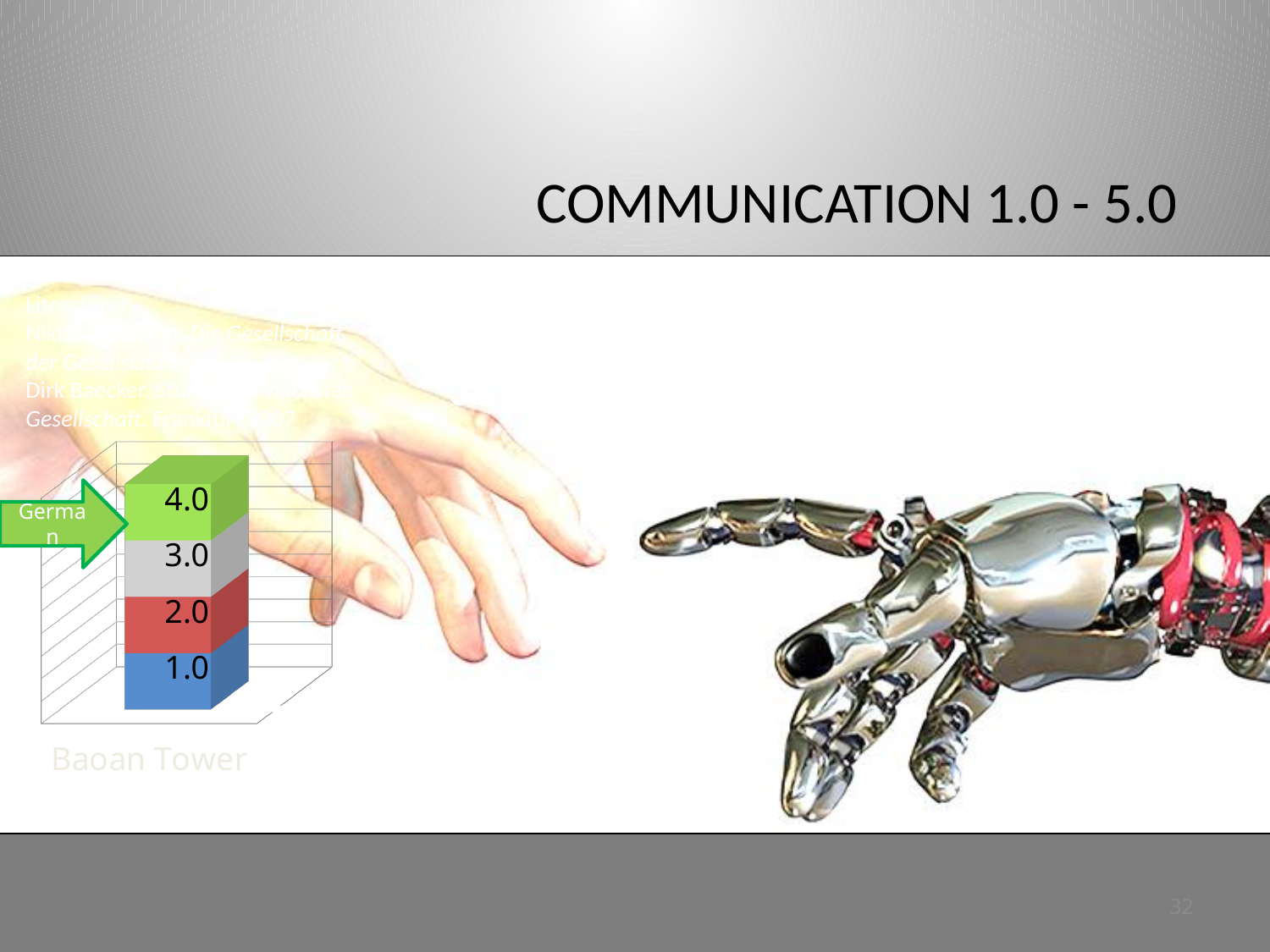
What label is printed on the grey segment of the stacked bar? 3.0 How many bars does the chart contain? 1 What label is printed on the bottom segment of the stacked bar? 1.0 What is the category label printed beneath the stacked bar? Baoan Tower What kind of chart is shown on the slide? stacked bar chart What colour is the segment labelled 4.0 in the stacked bar? green What label is printed on the top segment of the stacked bar? 4.0 What label is printed on the red segment of the stacked bar? 2.0 How many segments make up the stacked bar in the chart? 4